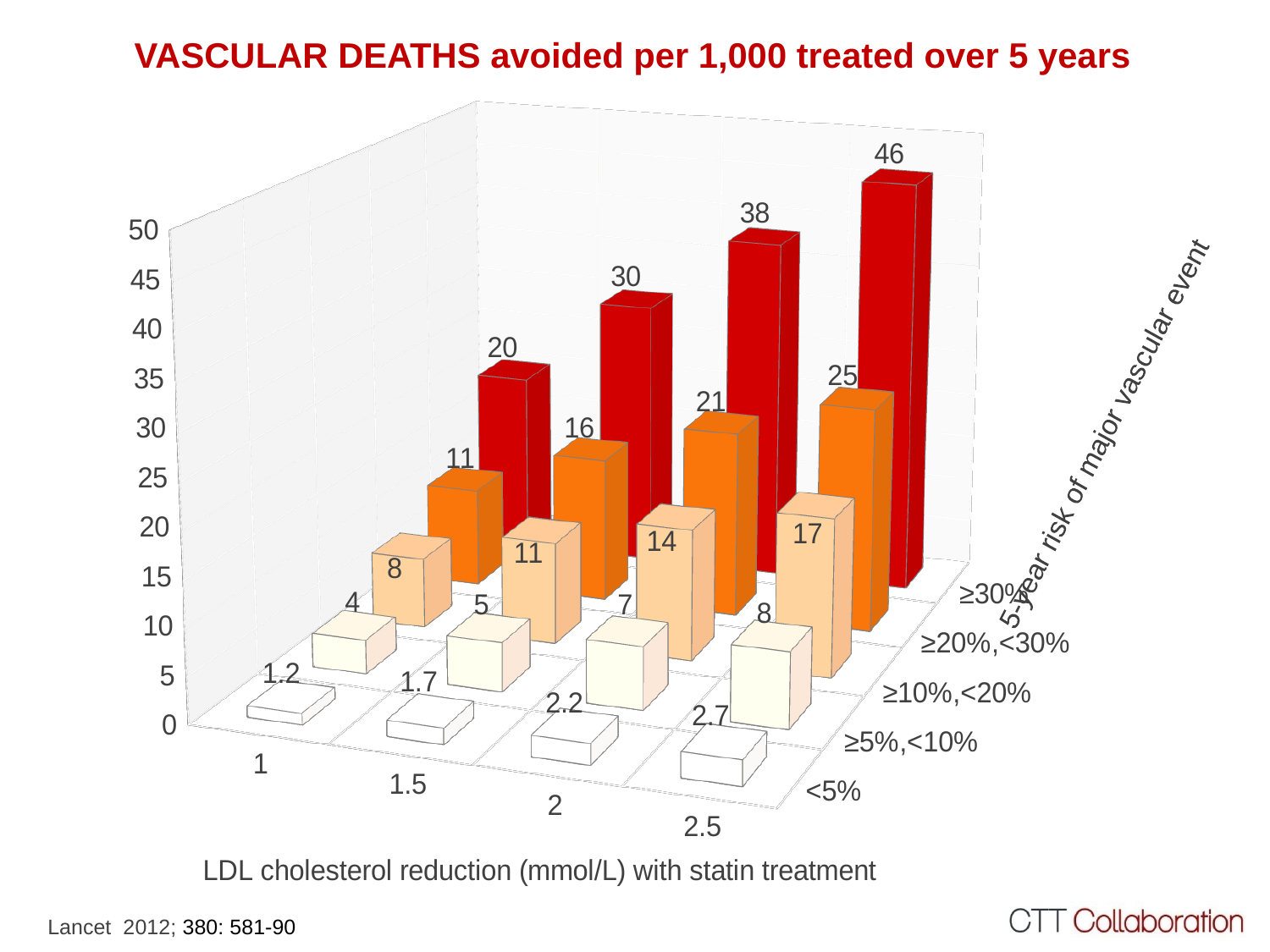
Which combination of LDL reduction and risk group has the highest number of vascular deaths avoided? 2.5 mmol/L, ≥30% How many 5-year risk categories are shown? 5 What is the value for an LDL reduction of 1 mmol/L in the <5% risk group? 1.2 Which is larger: the value for 2.5 mmol/L in the ≥20%,<30% group or the value for 1 mmol/L in the ≥30% group? 2.5 mmol/L in the ≥20%,<30% group What is the difference between the values for 2.5 mmol/L and 1 mmol/L in the ≥30% risk group? 26 Within the ≥30% risk group, do the values rise or fall as LDL cholesterol reduction increases? rise Which combination of LDL reduction and risk group has the lowest number of vascular deaths avoided? 1 mmol/L, <5% What is the number of vascular deaths avoided per 1,000 treated for an LDL reduction of 2.5 mmol/L in the ≥30% risk group? 46 What is the value for an LDL reduction of 1.5 mmol/L in the ≥20%,<30% risk group? 16 What is the value for an LDL reduction of 2 mmol/L in the ≥10%,<20% risk group? 14 What kind of chart is shown on the slide? 3D bar chart How many LDL cholesterol reduction levels are shown on the x axis? 4